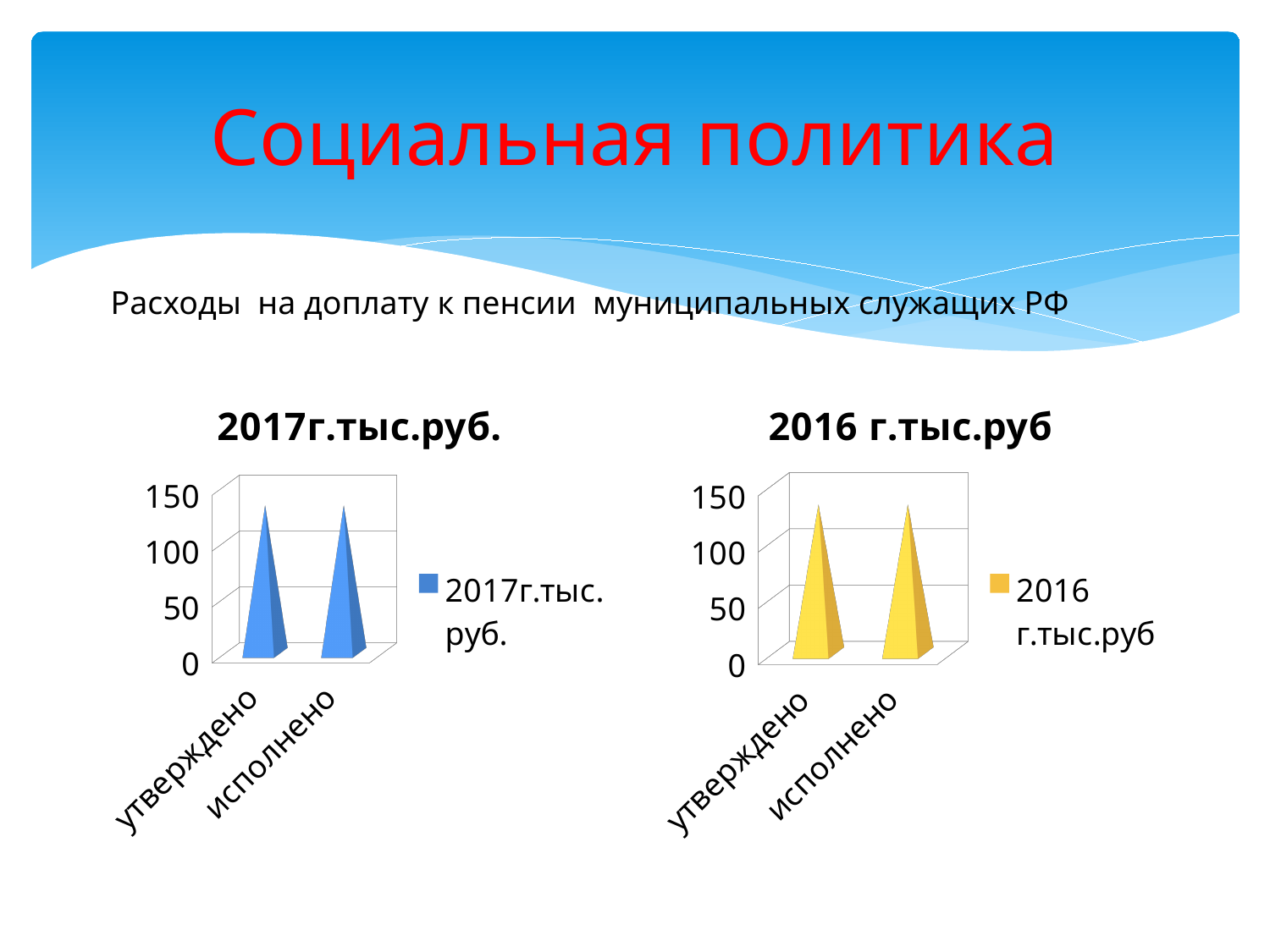
In the '2016 г.тыс.руб' chart, is the value for 'утверждено' greater or less than 100? greater What kind of chart is the '2017г.тыс.руб.' chart? bar chart In the '2016 г.тыс.руб' chart, how many categories are shown on the x axis? 2 In the '2017г.тыс.руб.' chart, is the value for 'исполнено' greater or less than 150? less What colour are the bars in the '2016 г.тыс.руб' chart? yellow What is the legend entry of the '2016 г.тыс.руб' chart? 2016 г.тыс.руб In the '2017г.тыс.руб.' chart, is the value for 'утверждено' greater or less than 100? greater How many charts are on the slide? 2 What kind of chart is the '2016 г.тыс.руб' chart? bar chart In the '2017г.тыс.руб.' chart, how many categories are shown on the x axis? 2 How many series does the legend of the '2017г.тыс.руб.' chart list? 1